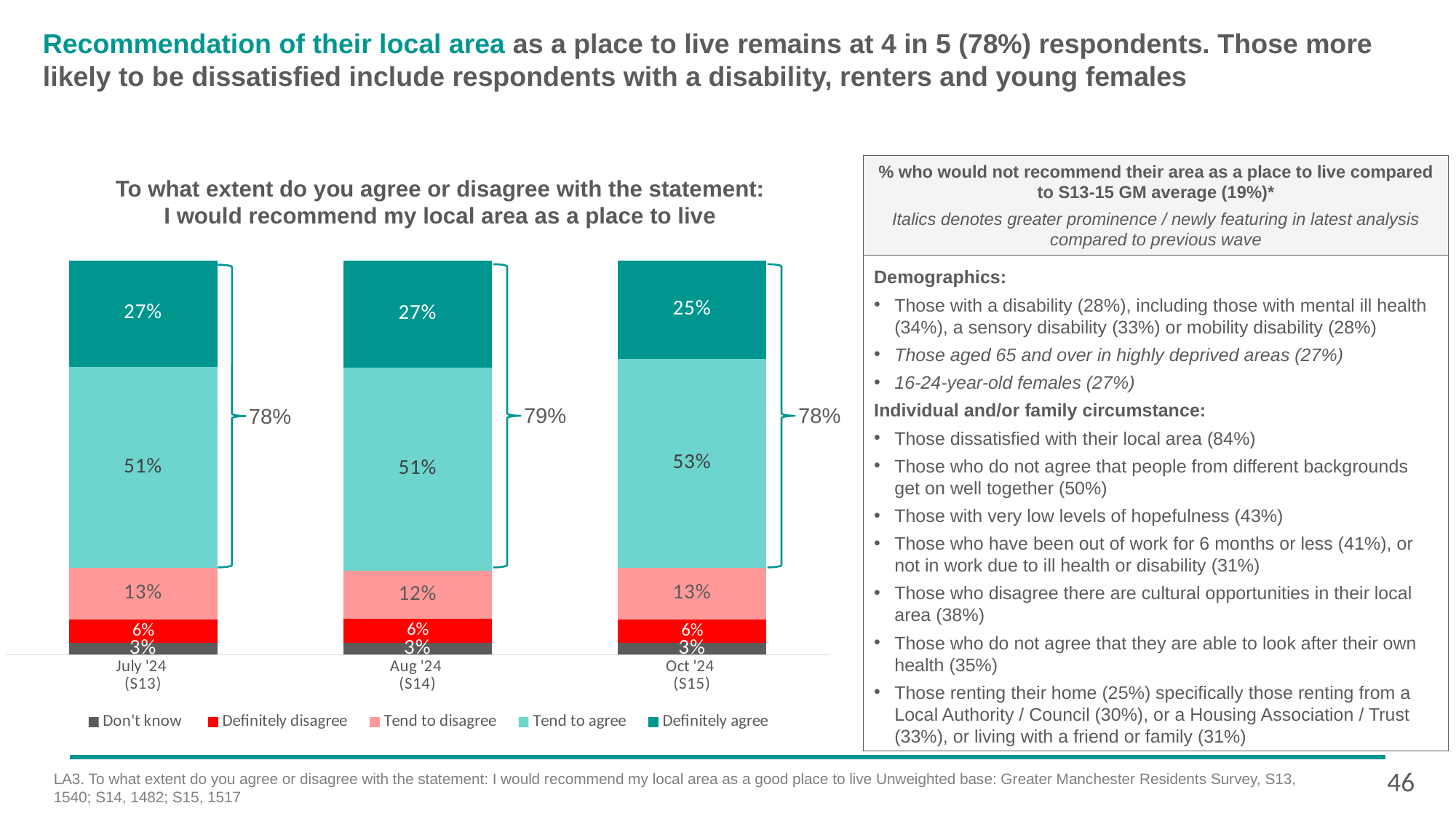
What is the difference between the 'Tend to agree' percentage in Oct '24 (S15) and in July '24 (S13)? 2% What percentage of respondents 'Tend to agree' in Aug '24 (S14)? 51% How many survey waves are shown on the x axis of the chart? 3 What percentage of respondents 'Definitely agree' in Oct '24 (S15)? 25% Which legend entry is shown in dark grey? Don't know Is the 'Definitely agree' percentage larger in July '24 (S13) or Oct '24 (S15)? July '24 (S13) What percentage of respondents 'Tend to disagree' in July '24 (S13)? 13% How many series does the chart legend list? 5 What is the combined agree percentage (Tend to agree plus Definitely agree) shown for Aug '24 (S14)? 79% Which wave has the highest 'Tend to agree' percentage? Oct '24 (S15) What kind of chart is used to show the agreement levels? Stacked bar chart Which wave has the lowest 'Definitely agree' percentage? Oct '24 (S15)